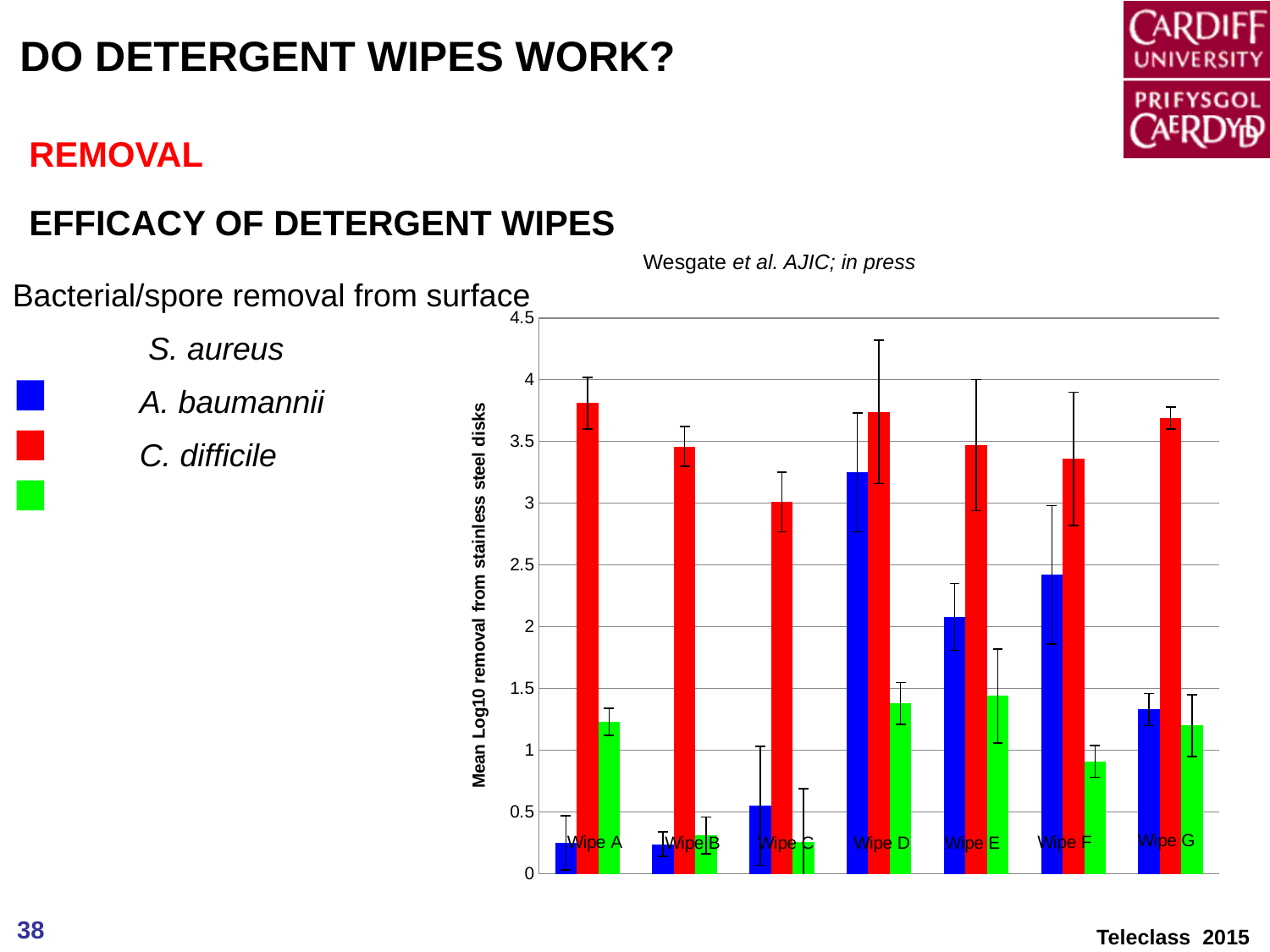
What kind of chart is shown on the slide? bar chart Which wipe has the highest blue bar? Wipe D What is the title of the y axis of the chart? Mean Log10 removal from stainless steel disks What is the label of the first category on the x axis of the chart? Wipe A How many wipe categories are shown on the x axis of the chart? 7 Is the blue bar for Wipe D greater or less than 3? greater Is the red bar for Wipe C greater or less than 3.5? less Is the blue bar for Wipe E greater or less than 2.5? less How many series (colours of bars) are plotted for each wipe in the chart? 3 Which wipe has the lowest red bar? Wipe C For Wipe A, which is larger, the red bar or the green bar? the red bar